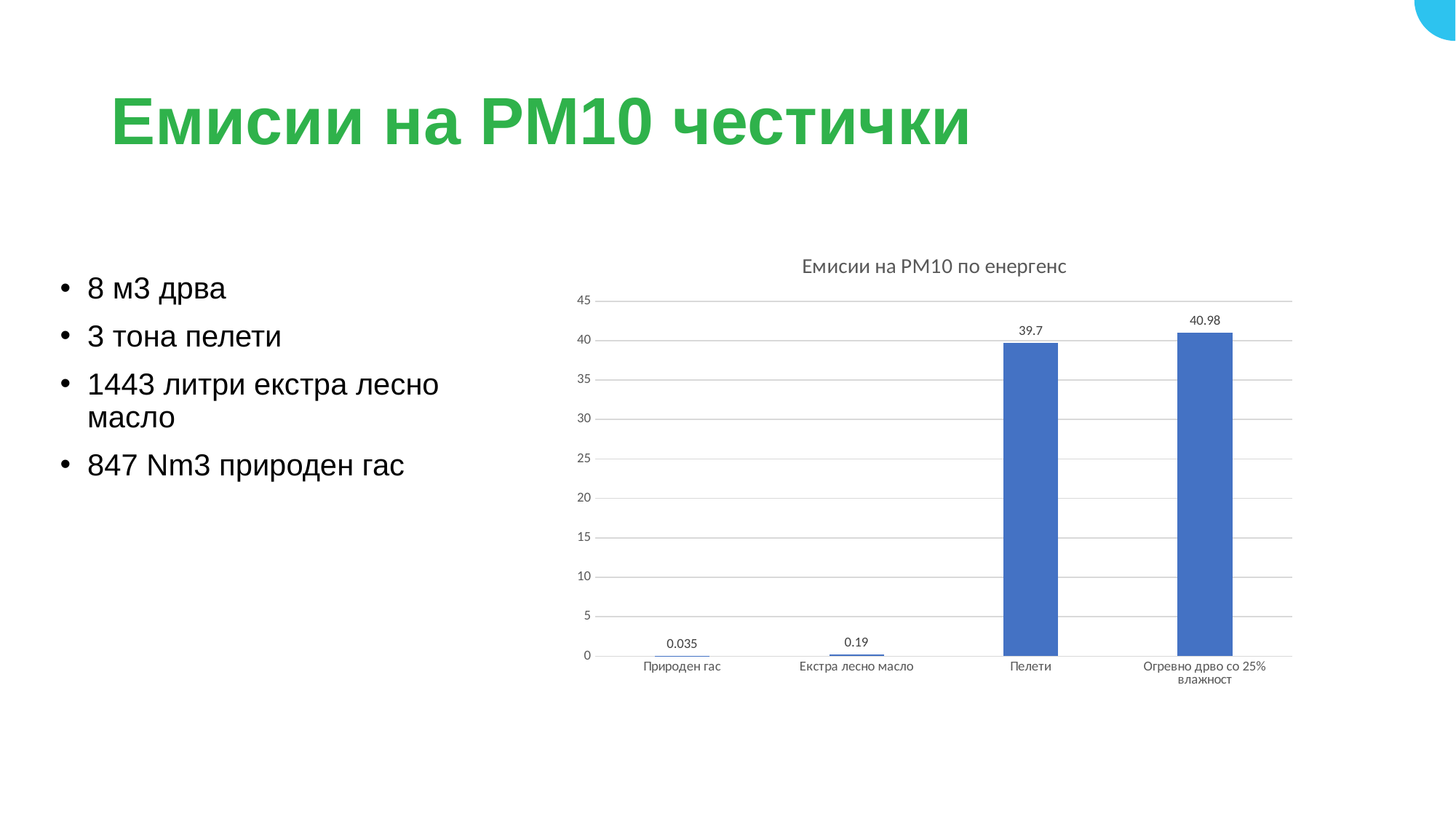
What is the title of the chart? Емисии на PM10 по енергенс What is the value for Екстра лесно масло? 0.19 What kind of chart is shown on the slide? bar chart Which is larger, the value for Екстра лесно масло or the value for Природен гас? Екстра лесно масло How many categories are shown on the x axis? 4 Which category has the lowest value? Природен гас What is the value for Огревно дрво со 25% влажност? 40.98 What is the value for Пелети? 39.7 What is the value for Природен гас? 0.035 What is the difference between the values for Огревно дрво со 25% влажност and Пелети? 1.28 Which category has the highest value? Огревно дрво со 25% влажност Is the value for Пелети greater or less than 35? greater